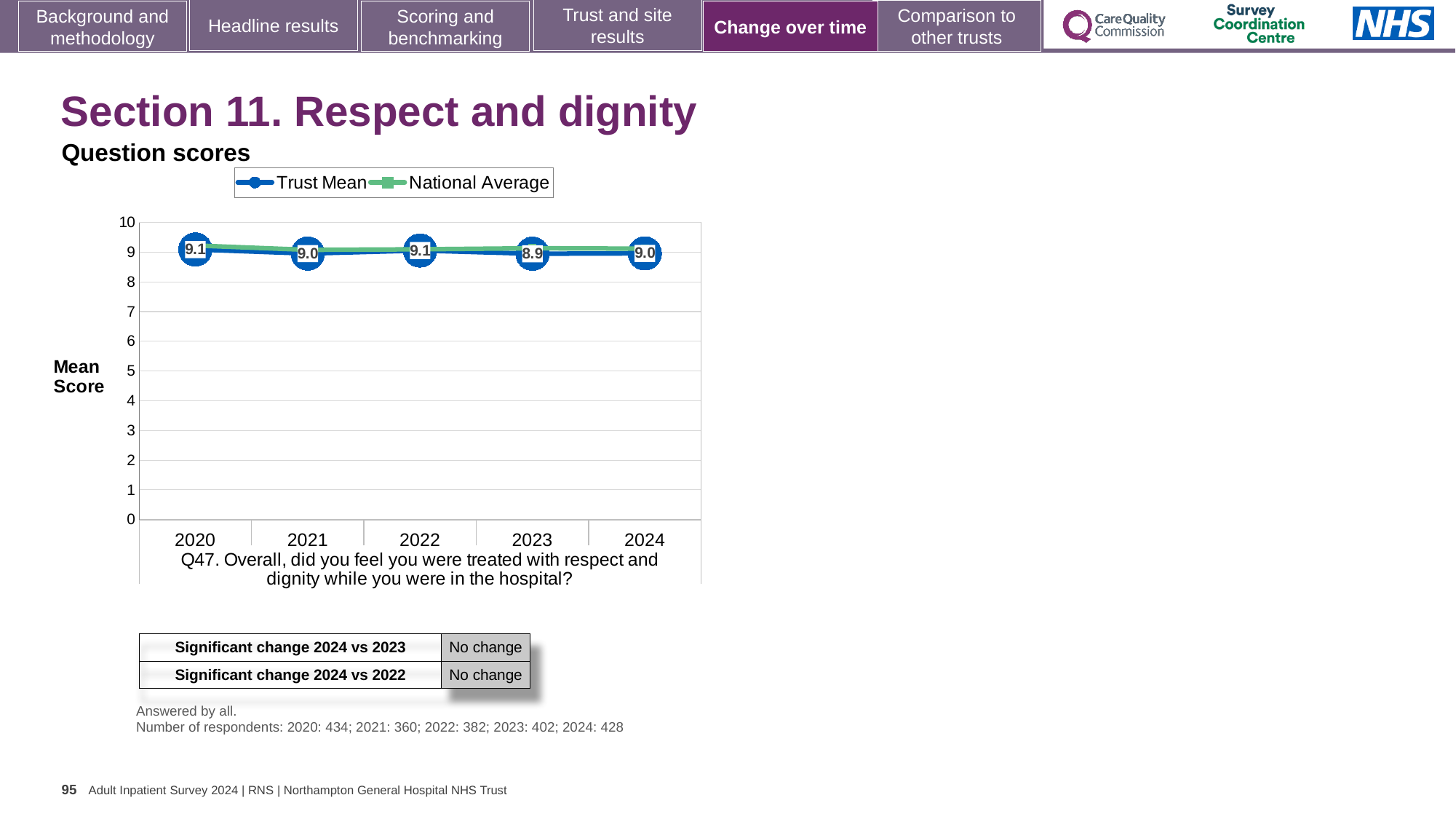
What is the difference between the Trust Mean score in 2022 and in 2023? 0.2 How many years are shown on the x axis? 5 What is the Trust Mean score for 2021? 9.0 Is the Trust Mean score for 2020 greater or less than 8? greater What kind of chart is shown? Line chart Which series is shown in green in the legend? National Average What is the label of the y axis? Mean Score What is the Trust Mean score for 2020? 9.1 In which year is the Trust Mean score lowest? 2023 What is the Trust Mean score for 2023? 8.9 How many series does the legend list? 2 What is the Trust Mean score for 2024? 9.0